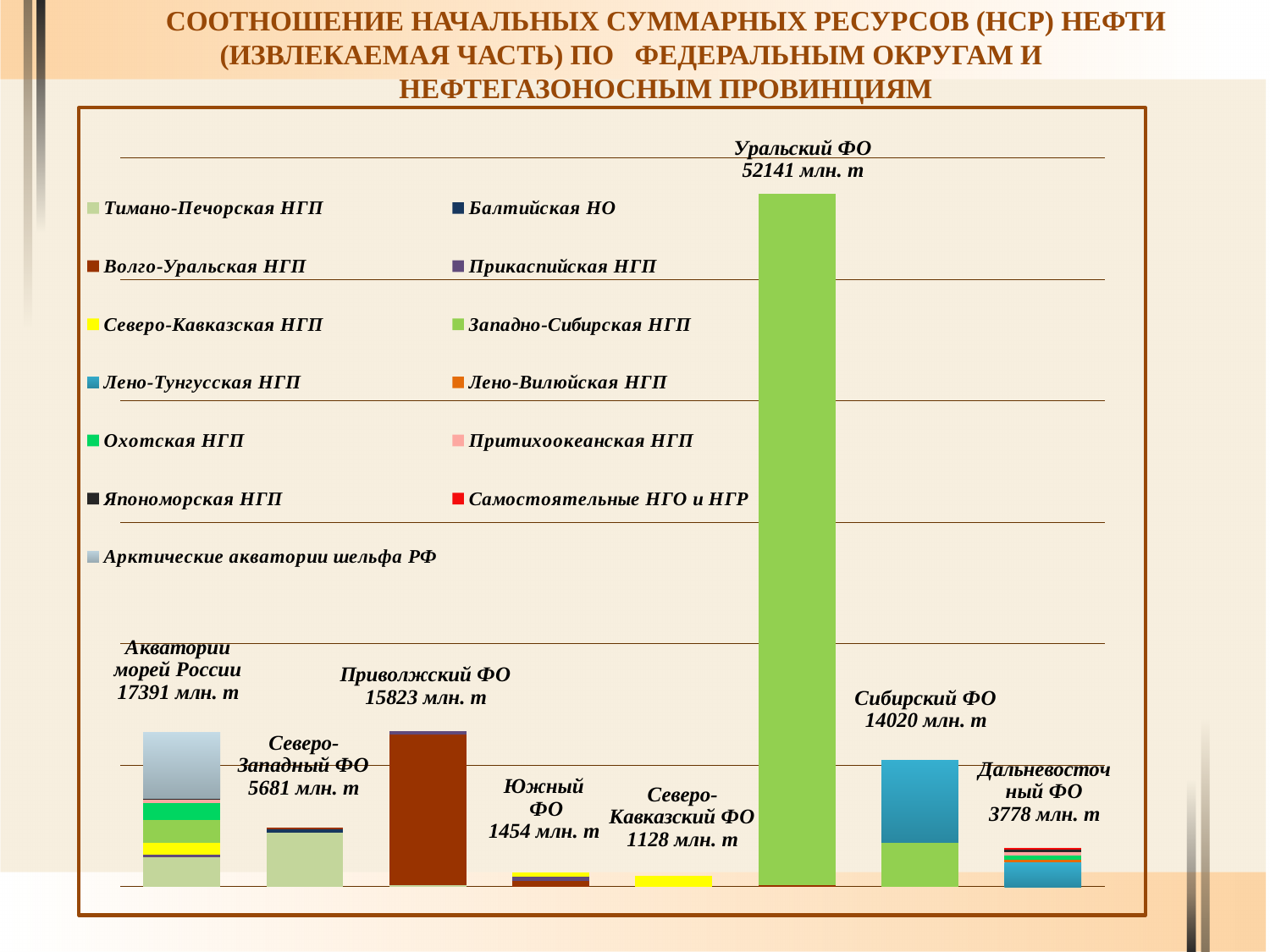
What is the difference between the totals for Уральский ФО and Сибирский ФО? 38121 млн. т What is the total value shown for Уральский ФО? 52141 млн. т How many categories (bars) are shown in the chart? 8 Which category has the highest total value? Уральский ФО What is the difference between the totals for Северо-Западный ФО and Дальневосточный ФО? 1903 млн. т What is the total value shown for Дальневосточный ФО? 3778 млн. т How many series does the legend list? 13 Which category has the lowest total value? Северо-Кавказский ФО Which has a larger total, Акватории морей России or Приволжский ФО? Акватории морей России What kind of chart is shown on the slide? Stacked bar chart What is the total value shown for Акватории морей России? 17391 млн. т What is the total value shown for Приволжский ФО? 15823 млн. т